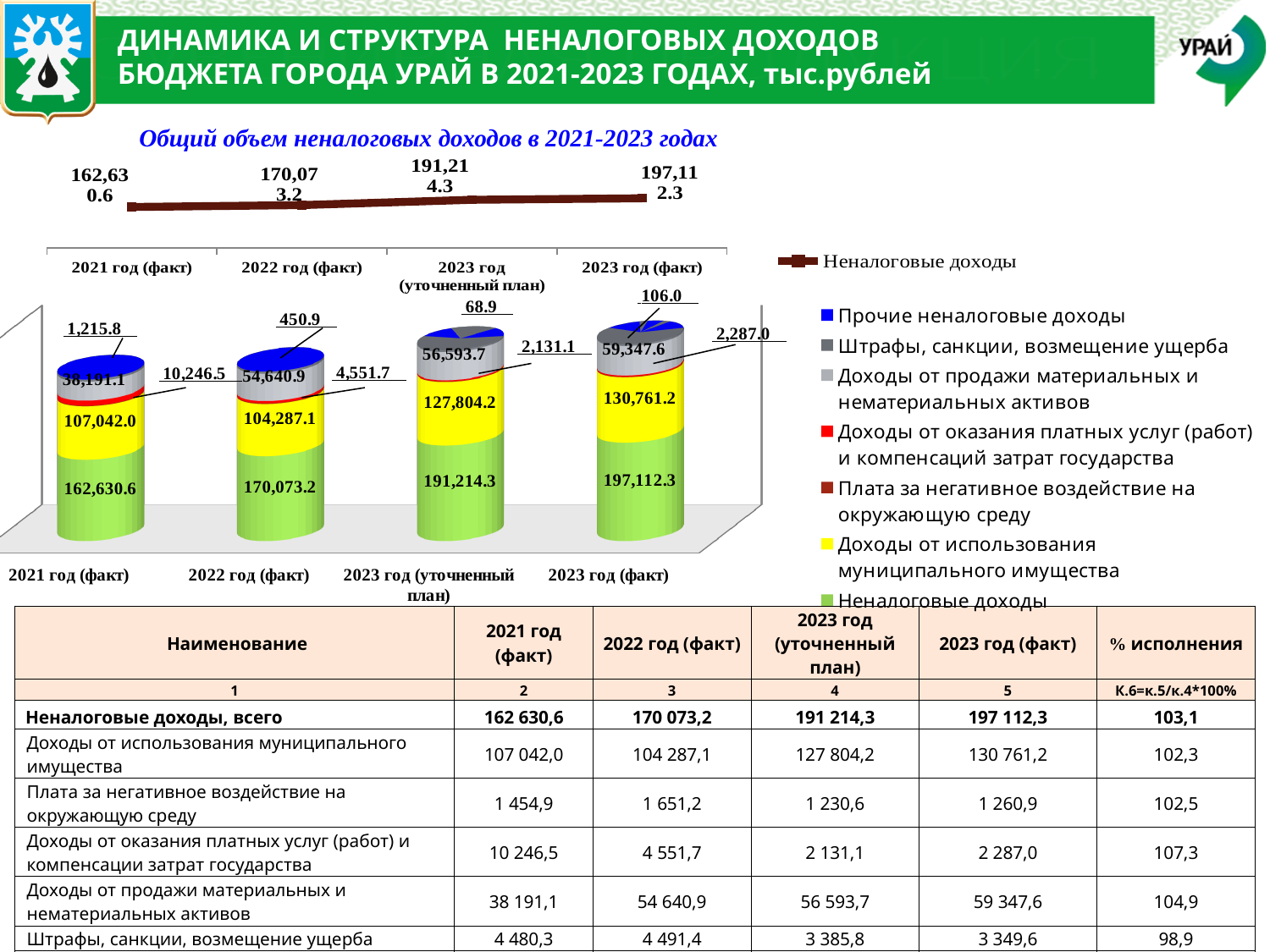
In the lower stacked bar chart, what is the value of the grey 'Доходы от продажи материальных и нематериальных активов' segment for 2023 год (уточненный план)? 56,593.7 In the lower stacked bar chart, what is the value of the yellow 'Доходы от использования муниципального имущества' segment for 2022 год (факт)? 104,287.1 In the lower stacked bar chart, how many series does the legend list? 7 In the lower stacked bar chart, how many categories are shown on the x axis? 4 In the lower stacked bar chart, what is the difference between the green 'Неналоговые доходы' values for 2023 год (факт) and 2021 год (факт)? 34,481.7 What kind of chart is the upper chart titled 'Общий объем неналоговых доходов в 2021-2023 годах'? line chart In the lower stacked bar chart, do the green 'Неналоговые доходы' values rise or fall from 2021 год (факт) to 2023 год (факт)? rise In the lower stacked bar chart, what is the value of the green 'Неналоговые доходы' segment for 2023 год (факт)? 197,112.3 In the lower stacked bar chart, which category has the lowest value for the blue 'Прочие неналоговые доходы' segment? 2023 год (уточненный план) In the lower stacked bar chart, which is larger for the red 'Доходы от оказания платных услуг' segment: 2021 год (факт) or 2022 год (факт)? 2021 год (факт) What kind of chart is the lower chart with the stacked cylinders? bar chart In the lower stacked bar chart, which category has the highest value for the green 'Неналоговые доходы' segment? 2023 год (факт)